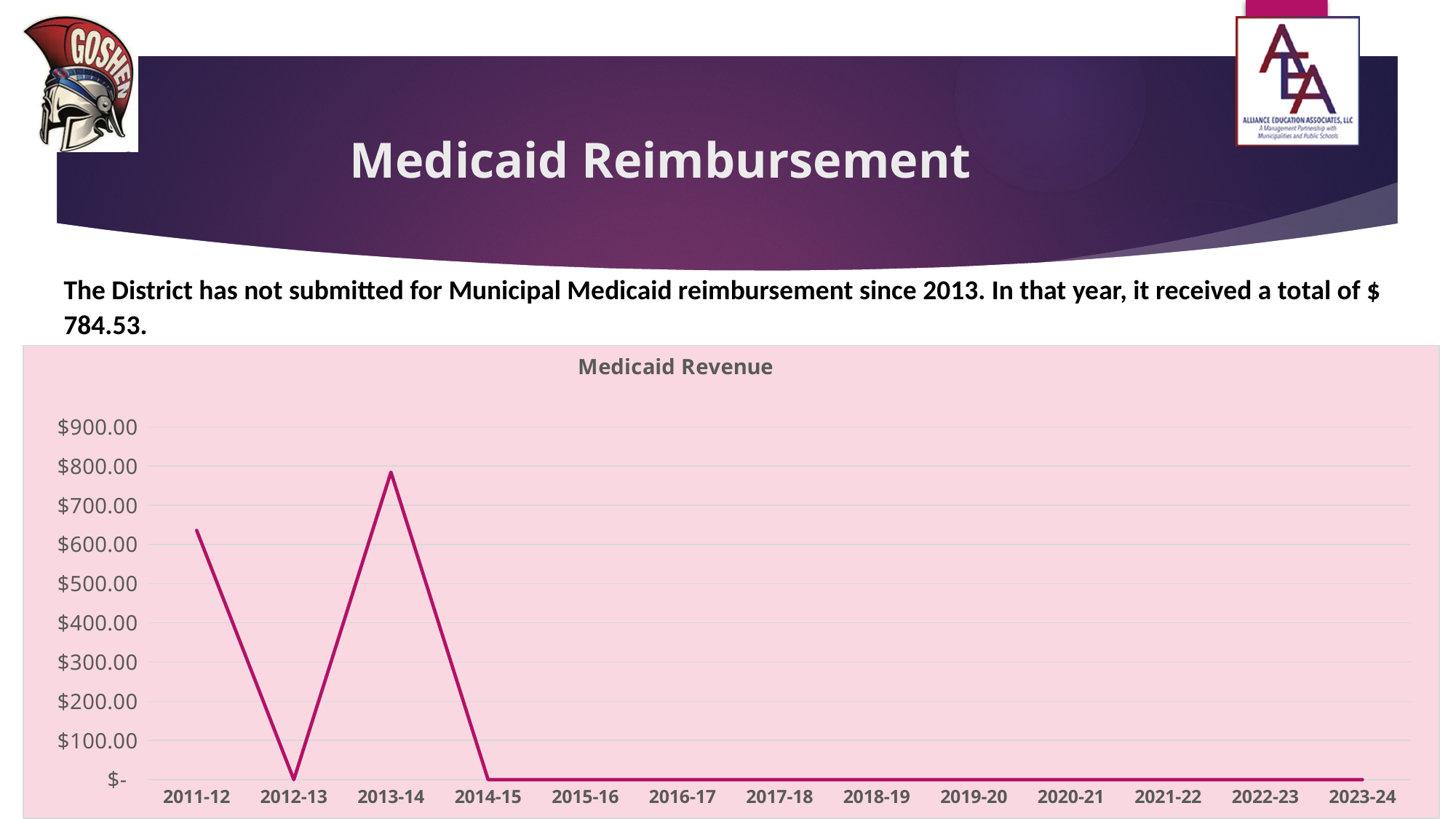
Is the Medicaid Revenue for 2011-12 greater or less than $600.00? greater Is the Medicaid Revenue for 2013-14 greater or less than $700.00? greater What is the title of the chart? Medicaid Revenue How many school years are plotted along the x axis of the Medicaid Revenue chart? 13 Is the Medicaid Revenue for 2011-12 greater or less than $700.00? less Which year has the larger Medicaid Revenue, 2011-12 or 2013-14? 2013-14 What kind of chart is shown on the slide? line chart Which is the first school year on the chart where Medicaid Revenue is $-? 2012-13 What is the Medicaid Revenue value for 2012-13? $- Which school year has the highest Medicaid Revenue? 2013-14 What is the Medicaid Revenue value for 2018-19? $- Does the Medicaid Revenue rise or fall from 2013-14 to 2014-15? fall